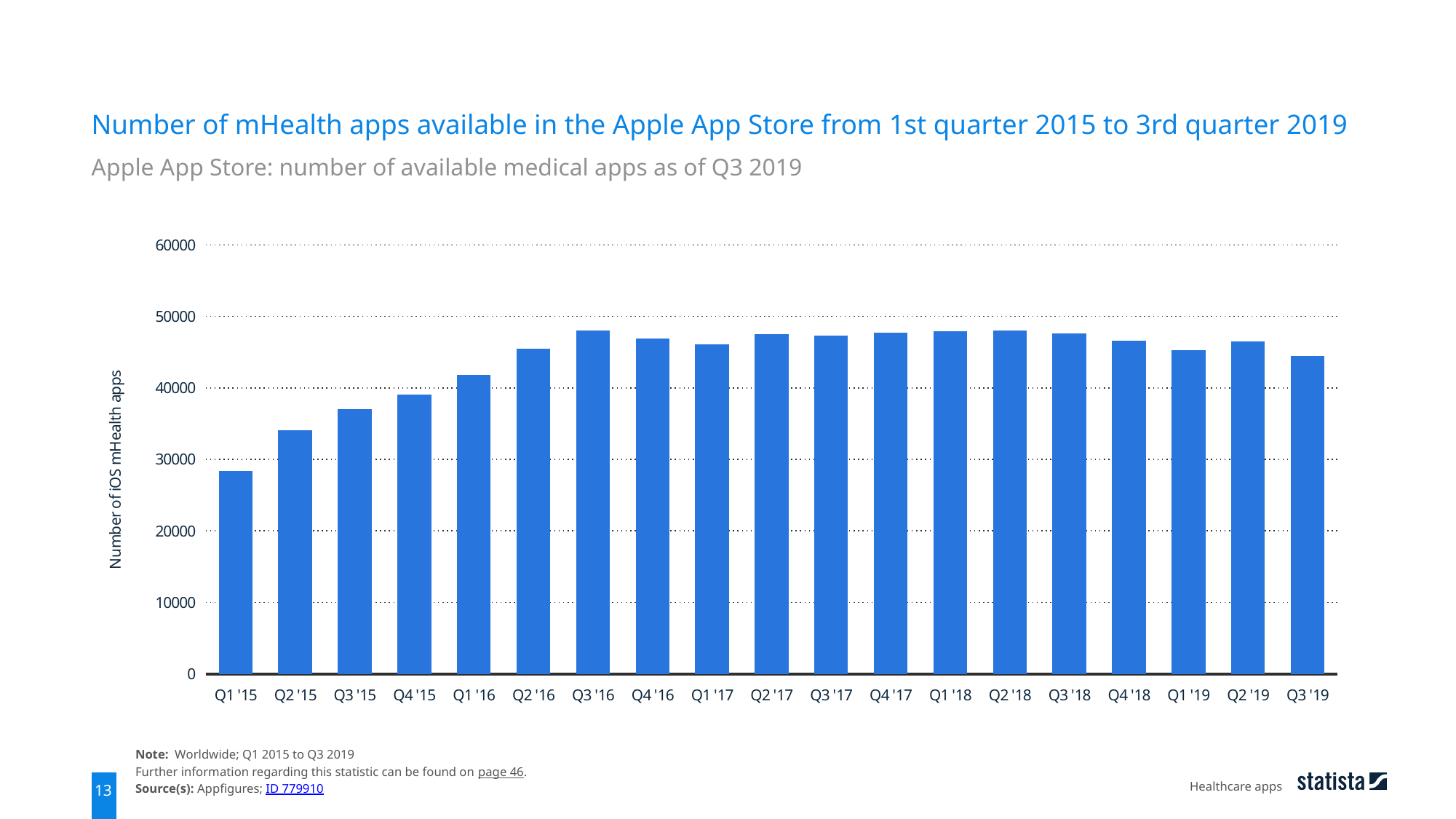
Which is larger, the value for Q1 '15 or the value for Q2 '15? Q2 '15 Is the value for Q4 '15 greater or less than 40000? less Is the value for Q3 '19 greater or less than 40000? greater How many quarters are plotted on the x axis? 19 What kind of chart is shown on the slide? bar chart Is the value for Q2 '15 greater or less than 30000? greater Which quarter has the lowest number of mHealth apps? Q1 '15 What is the label on the y axis? Number of iOS mHealth apps Which is larger, the value for Q3 '15 or the value for Q2 '16? Q2 '16 Do the values rise or fall from Q1 '15 to Q3 '16? rise